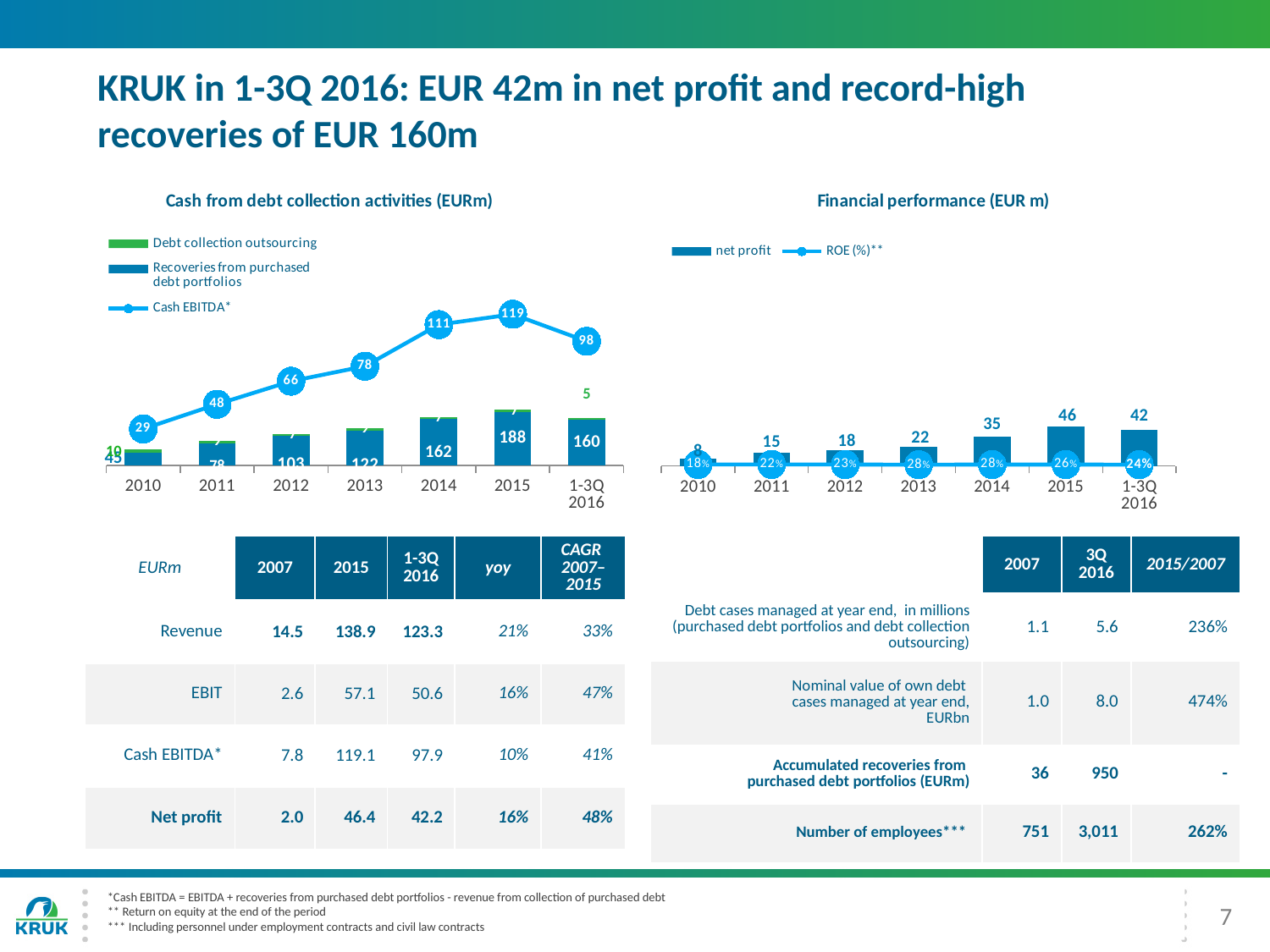
In the 'Cash from debt collection activities (EURm)' chart, how many series does the legend list? 3 In the 'Cash from debt collection activities (EURm)' chart, which year has the highest Cash EBITDA*? 2015 In the 'Financial performance (EUR m)' chart, which is larger, net profit in 2014 or in 2013? 2014 In the 'Financial performance (EUR m)' chart, which period has the highest net profit? 2015 In the 'Financial performance (EUR m)' chart, what is the net profit for 1-3Q 2016? 42 In the 'Cash from debt collection activities (EURm)' chart, what is the Cash EBITDA* value for 2015? 119 In the 'Cash from debt collection activities (EURm)' chart, does Cash EBITDA* rise or fall from 2010 to 2015? rise In the 'Cash from debt collection activities (EURm)' chart, what are the recoveries from purchased debt portfolios for 2015? 188 In the 'Financial performance (EUR m)' chart, what is the ROE (%) for 2013? 28% In the 'Cash from debt collection activities (EURm)' chart, what is the difference between Cash EBITDA* in 2015 and in 2014? 8 In the 'Financial performance (EUR m)' chart, how many periods are shown on the x axis? 7 In the 'Cash from debt collection activities (EURm)' chart, what is the Cash EBITDA* value for 1-3Q 2016? 98